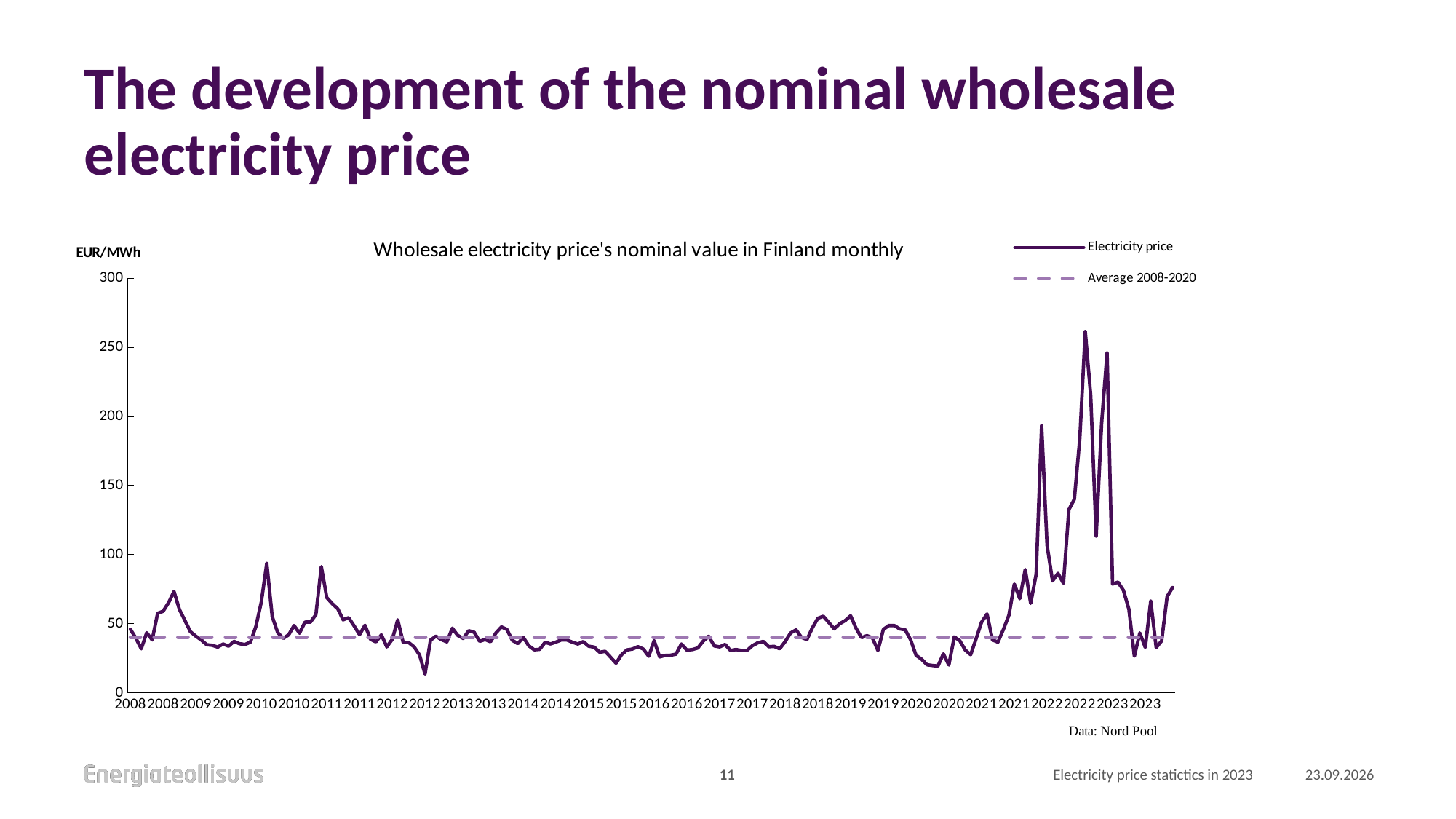
Is the highest electricity price in 2022 greater or less than 200? greater Which is higher: the peak electricity price in 2022 or the peak in 2010? 2022 Is the lowest electricity price in 2012 greater or less than 50? less Is the electricity price at the start of 2008 greater or less than 100? less Does the electricity price rise or fall from the start of 2021 to its peak in 2022? rise What does the dashed line in the chart represent, according to the legend? Average 2008-2020 What kind of chart is shown on the slide? line chart What is the title of the chart? Wholesale electricity price's nominal value in Finland monthly In which year does the electricity price reach its highest value? 2022 How many series does the legend list? 2